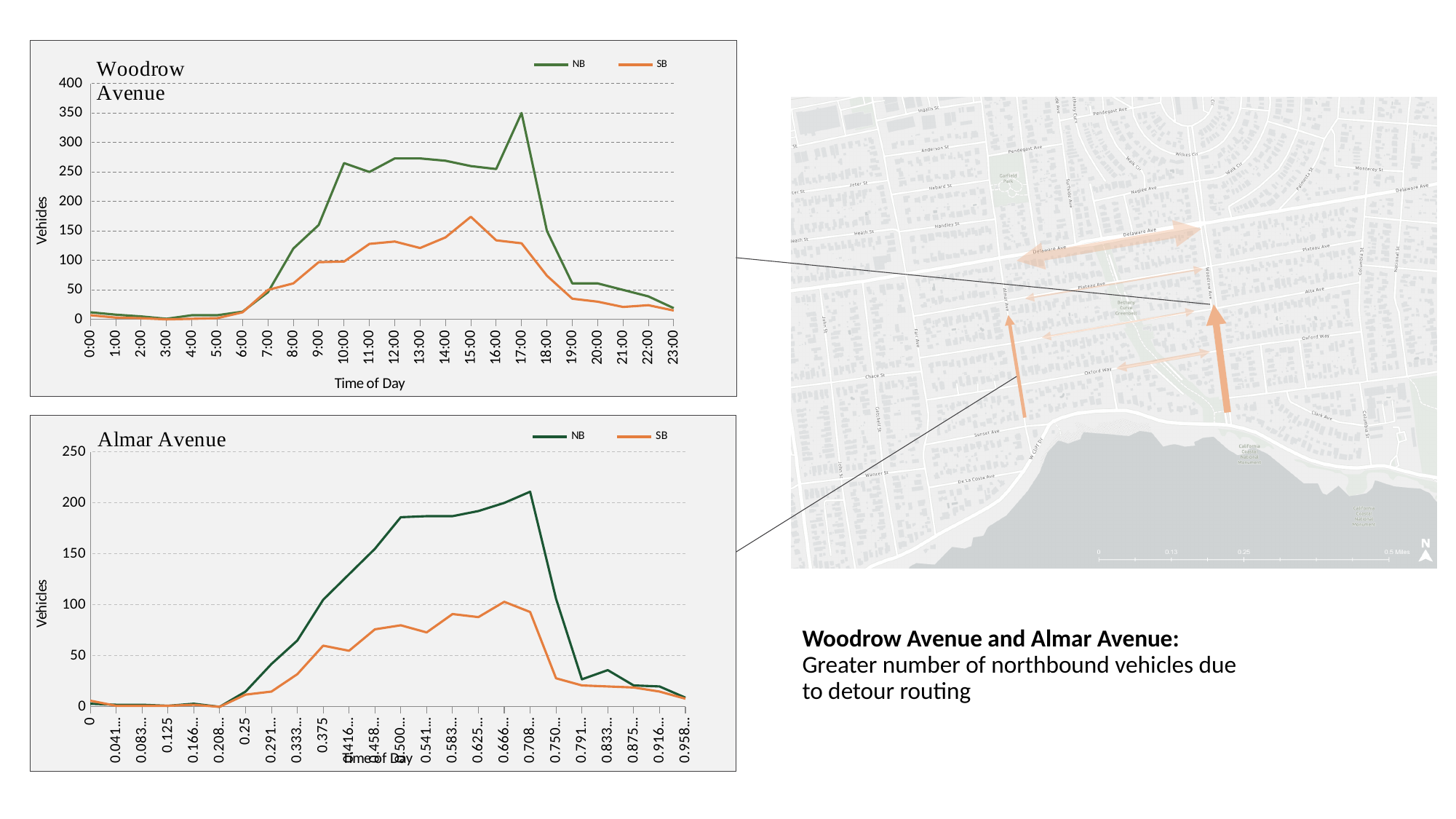
In the Woodrow Avenue chart, at what time of day does the NB series reach its highest value? 17:00 How many series does the legend of the Almar Avenue chart list? 2 In the Woodrow Avenue chart, is the SB value at 15:00 greater or less than 150? greater In the Woodrow Avenue chart, does the NB series rise or fall between 17:00 and 23:00? Fall In the Woodrow Avenue chart, which series is larger at 12:00, NB or SB? NB In the Almar Avenue chart, is the peak value of the SB series greater or less than 150? less What kind of chart is the Woodrow Avenue chart? Line chart In the Almar Avenue chart, which colour is used for the SB series? Orange In the Woodrow Avenue chart, is the NB value at 17:00 greater or less than 300? greater In the Woodrow Avenue chart, how many time-of-day points are shown on the x axis? 24 In the Woodrow Avenue chart, at what time of day does the SB series reach its highest value? 15:00